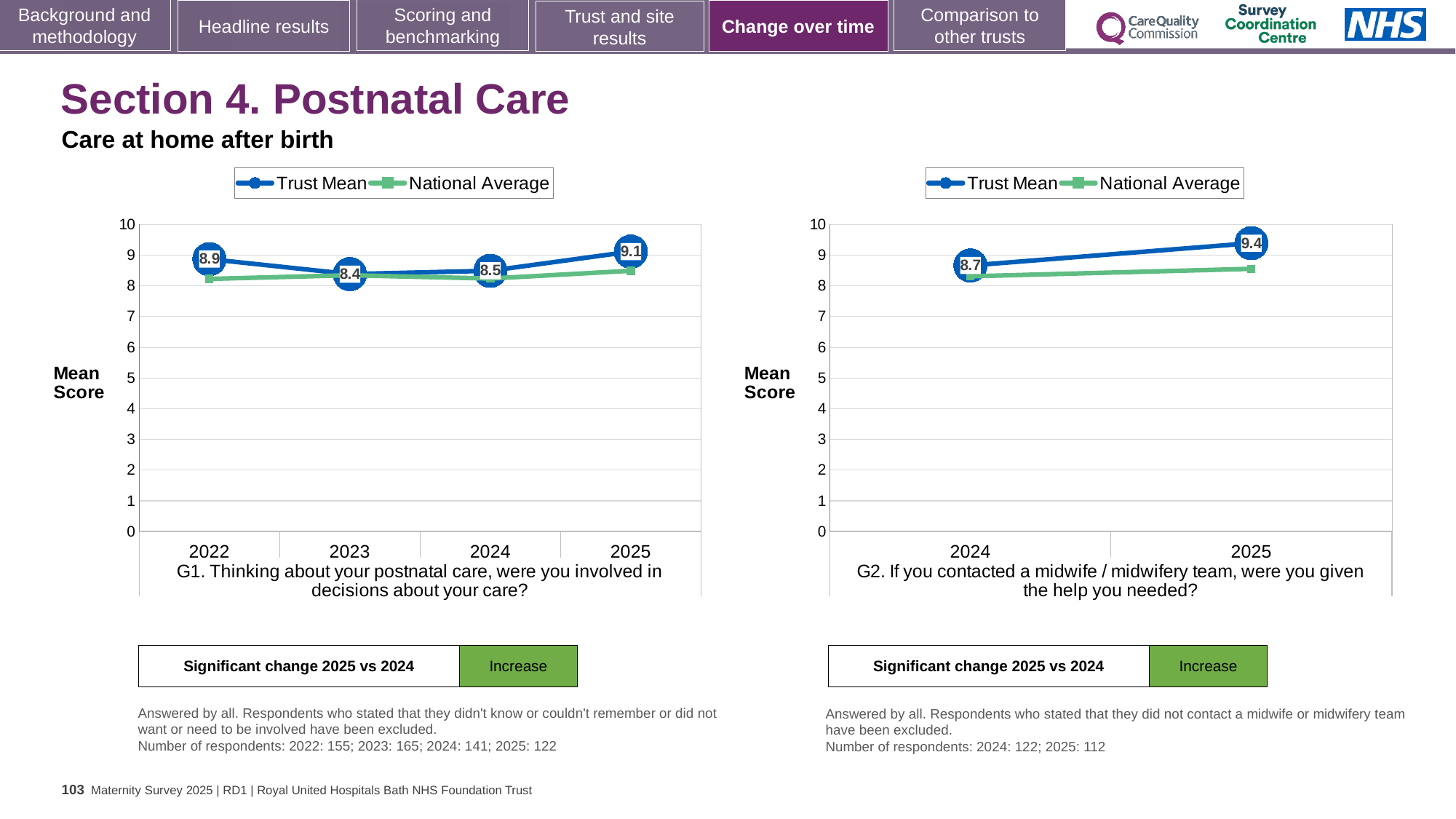
In the left chart (G1), what is the difference between the Trust Mean scores for 2025 and 2023? 0.7 In the left chart (G1), which year has the highest Trust Mean score? 2025 In the left chart (G1), which year has the lowest Trust Mean score? 2023 In the left chart (G1), is the Trust Mean score for 2022 or 2024 larger? 2022 In the left chart (G1), what is the Trust Mean score for 2025? 9.1 How many years are shown on the x axis of the left chart (G1)? 4 In the right chart (G2), what is the Trust Mean score for 2024? 8.7 In the left chart (G1), what is the Trust Mean score for 2022? 8.9 How many series does the legend of the right chart (G2) list? 2 What kind of chart is the right chart (G2)? Line chart In the right chart (G2), what is the Trust Mean score for 2025? 9.4 In the right chart (G2), what is the difference between the Trust Mean scores for 2025 and 2024? 0.7